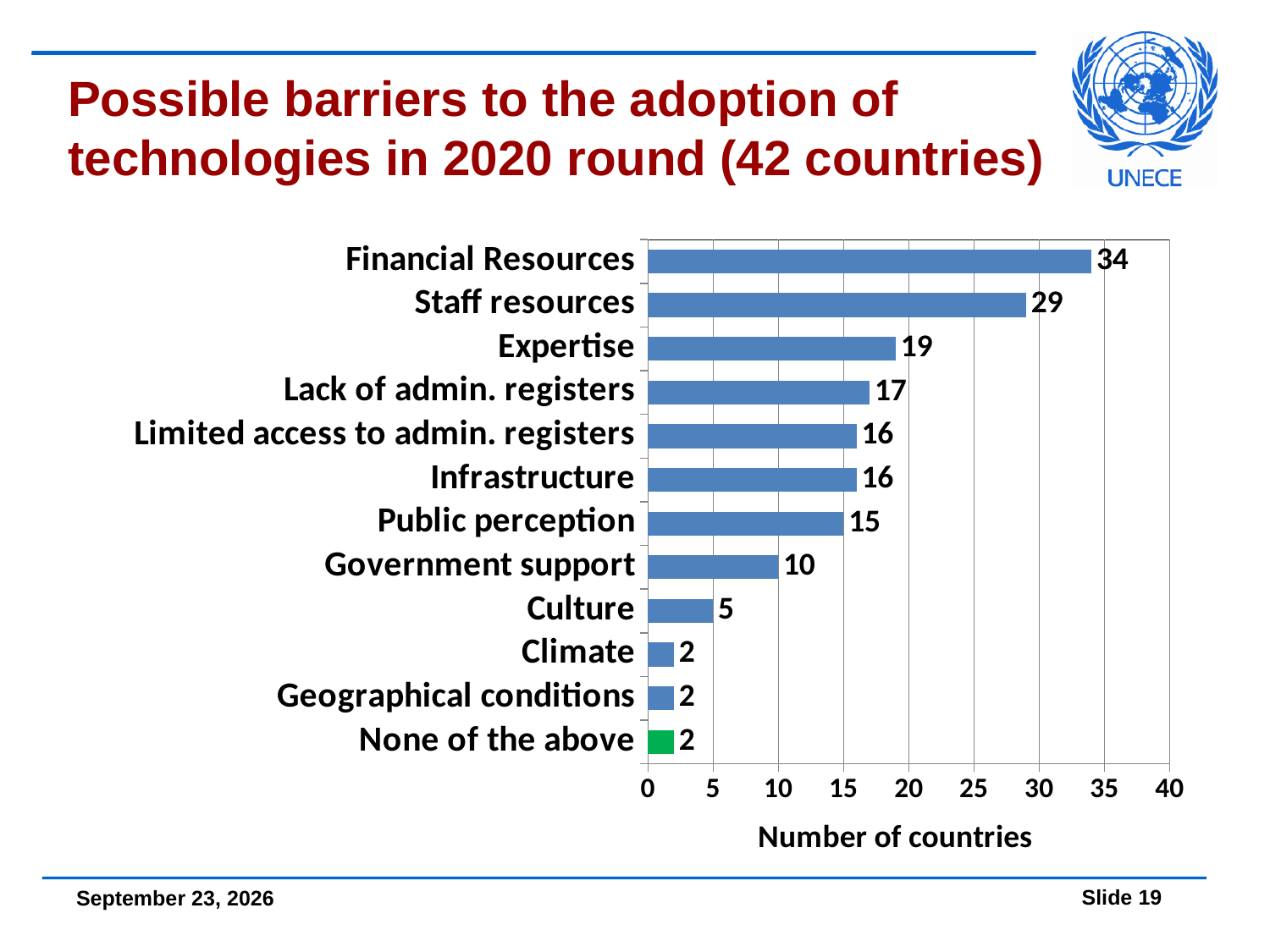
What is the difference between the values for Financial Resources and Staff resources? 5 What is the value for Public perception? 15 Is the value for Staff resources greater or less than 25? greater Which is larger, the value for Lack of admin. registers or the value for Infrastructure? Lack of admin. registers How many categories are shown in the chart? 12 Which barrier has the highest number of countries? Financial Resources What kind of chart is shown on the slide? Bar chart What is the value for Government support? 10 How many countries cited Financial Resources as a possible barrier? 34 What is the difference between the values for Expertise and Culture? 14 What is the label of the horizontal axis? Number of countries Which category's bar is coloured green rather than blue? None of the above